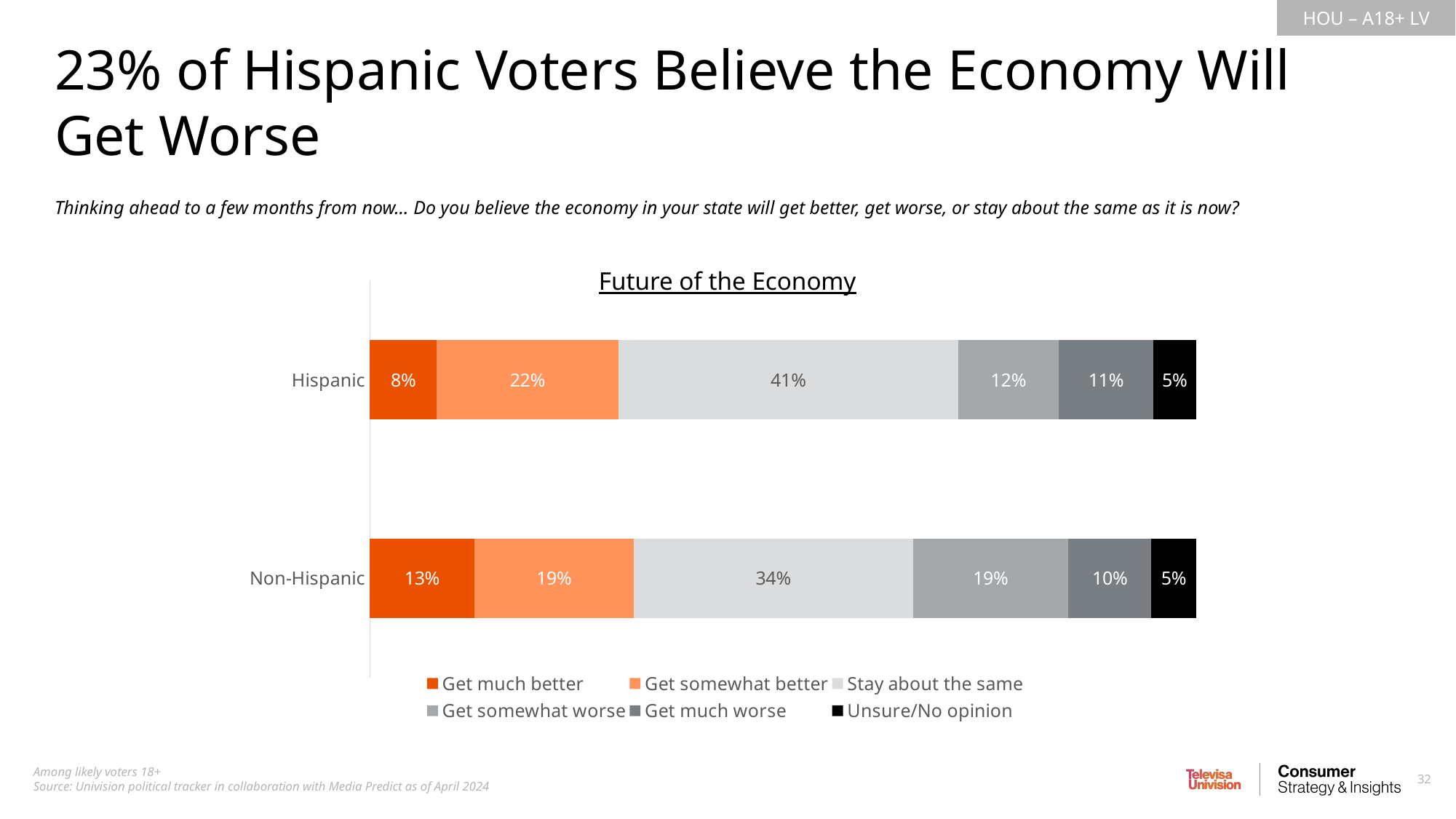
How many series does the legend list? 6 What percentage of Non-Hispanic voters are unsure or have no opinion? 5% What percentage of Hispanic voters say the economy will stay about the same? 41% How many groups (bars) are shown in the chart? 2 What is the title of the chart? Future of the Economy What percentage of Non-Hispanic voters say the economy will get much better? 13% What type of chart is shown on the slide? Stacked bar chart Which response category has the largest share among Hispanic voters? Stay about the same Which group has a larger share saying the economy will get somewhat worse, Hispanic or Non-Hispanic? Non-Hispanic What percentage of Hispanic voters say the economy will get somewhat worse? 12% Which response category has the smallest share among Non-Hispanic voters? Unsure/No opinion What is the difference between the Hispanic and Non-Hispanic shares for 'Stay about the same'? 7 percentage points